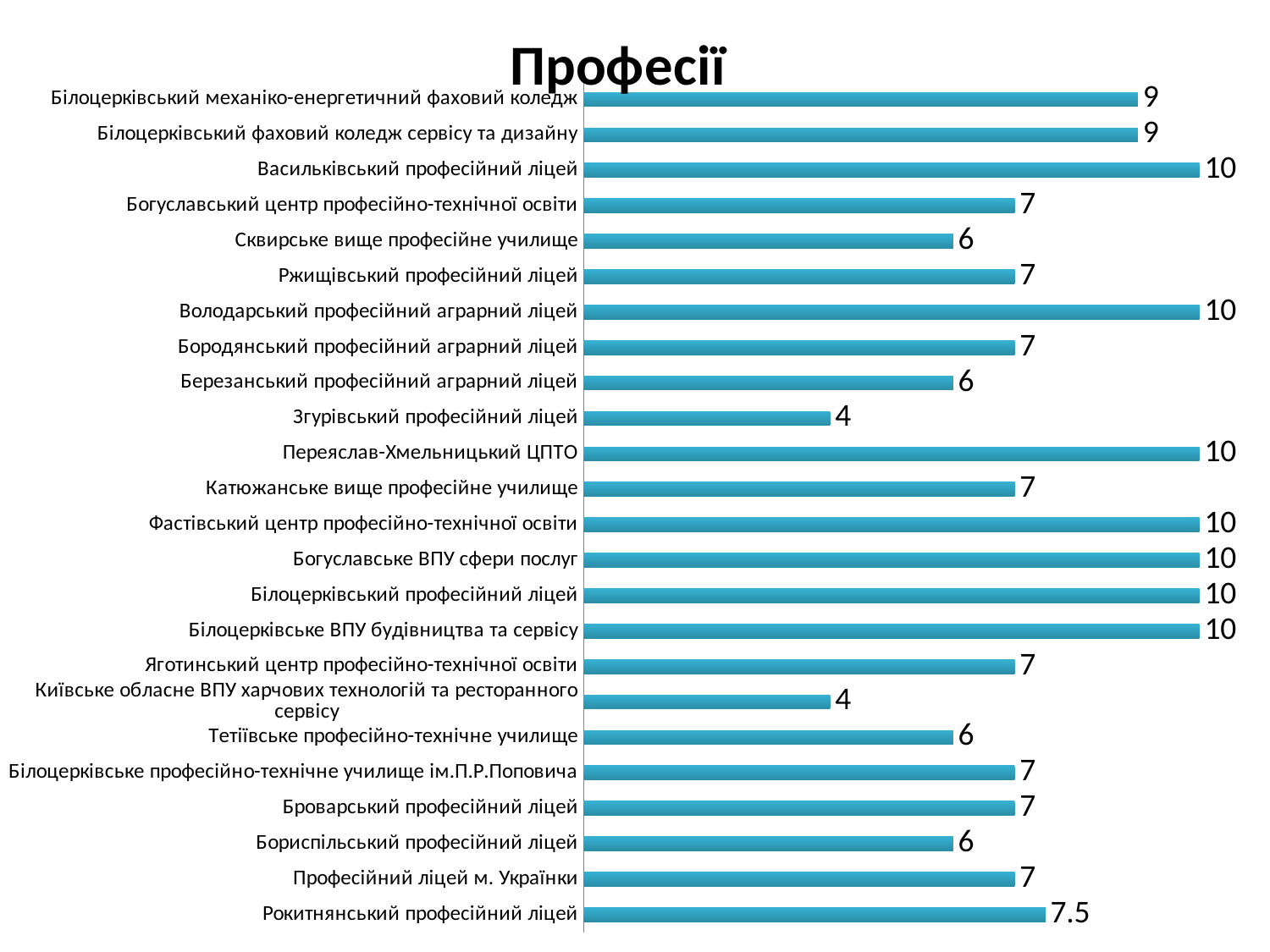
What is the title of the chart? Професії What is the value for Сквирське вище професійне училище? 6 What is the value for Васильківський професійний ліцей? 10 What is the difference between the values for Переяслав-Хмельницький ЦПТО and Згурівський професійний ліцей? 6 What is the value for Рокитнянський професійний ліцей? 7.5 What kind of chart is shown on the slide? bar chart How many categories (institutions) are shown on the chart? 24 What is the lowest value shown on the chart? 4 What is the value for Згурівський професійний ліцей? 4 What is the highest value shown on the chart? 10 What is the value for Білоцерківський фаховий коледж сервісу та дизайну? 9 Which has a larger value, Бориспільський професійний ліцей or Броварський професійний ліцей? Броварський професійний ліцей